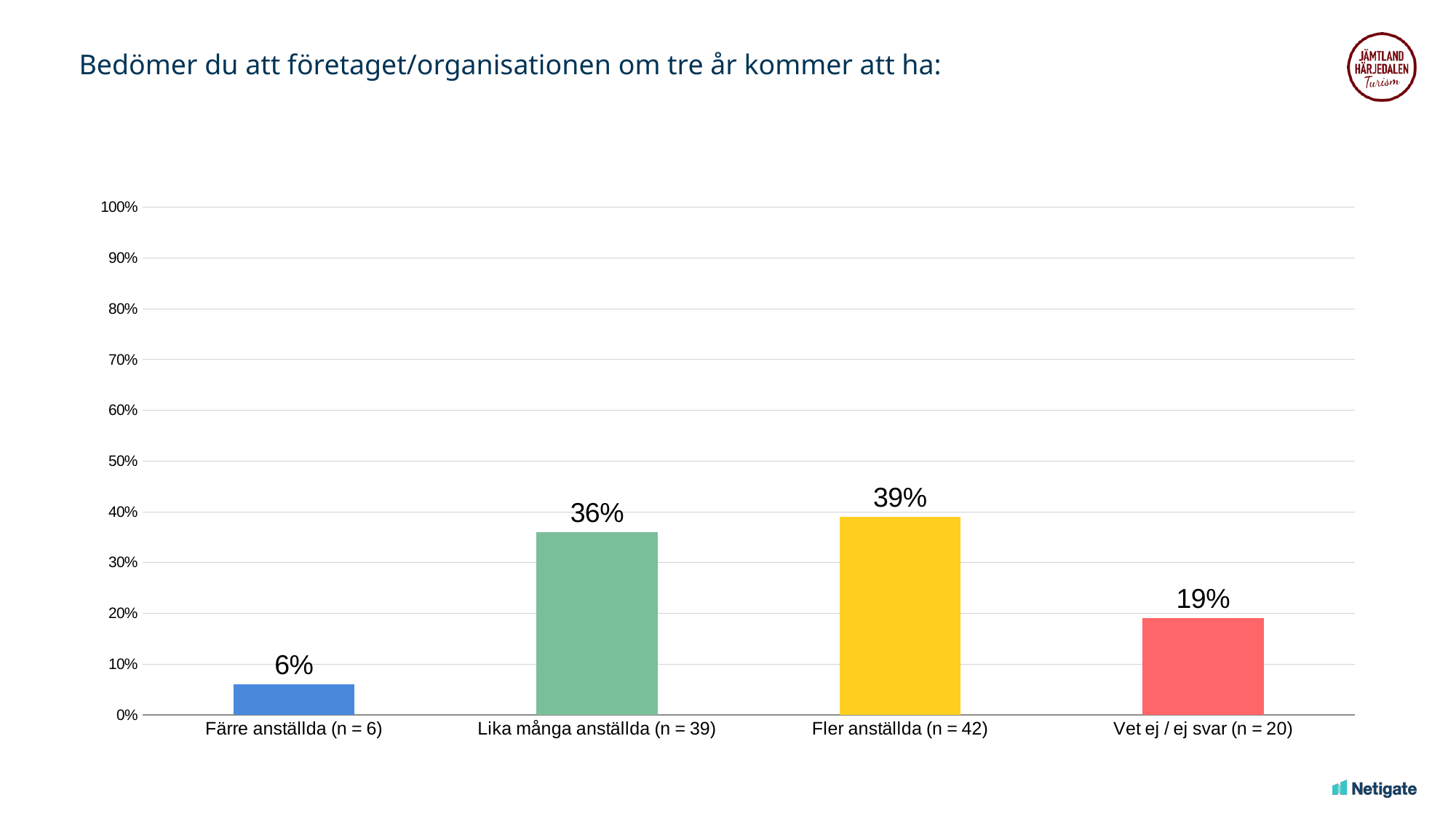
What is the difference between the values for "Vet ej / ej svar (n = 20)" and "Färre anställda (n = 6)"? 13% How many categories are shown in the chart? 4 What is the value for "Färre anställda (n = 6)"? 6% What kind of chart is shown on the slide? Bar chart Which is larger: the value for "Lika många anställda (n = 39)" or the value for "Vet ej / ej svar (n = 20)"? Lika många anställda (n = 39) Which category has the highest value? Fler anställda (n = 42) Is the value for "Fler anställda (n = 42)" greater or less than 50%? less What is the value for "Vet ej / ej svar (n = 20)"? 19% What is the value for "Fler anställda (n = 42)"? 39% What is the difference between the values for "Fler anställda (n = 42)" and "Lika många anställda (n = 39)"? 3% What is the value for "Lika många anställda (n = 39)"? 36% Which category has the lowest value? Färre anställda (n = 6)